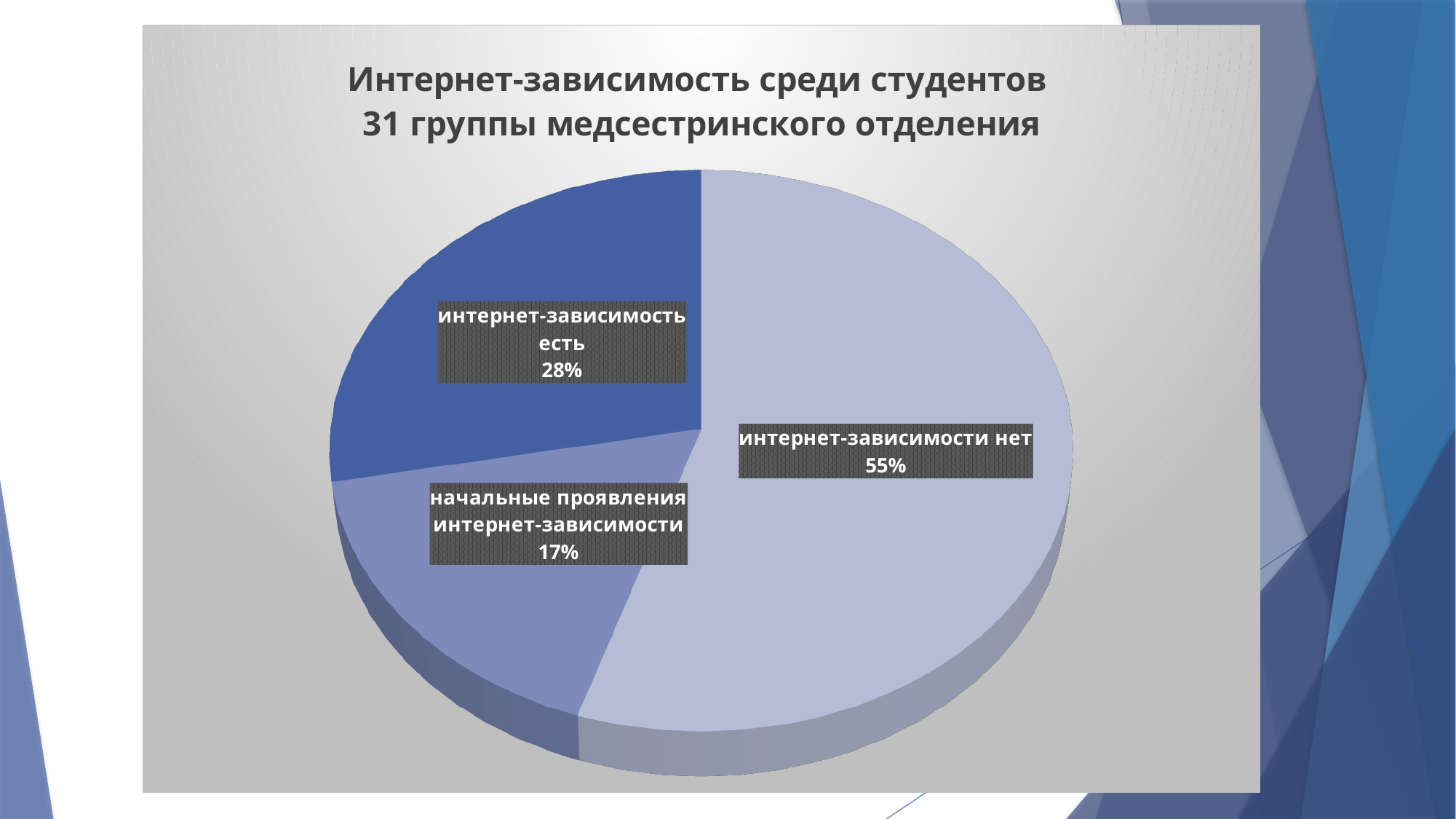
What is the difference in percentage points between 'интернет-зависимость есть' and 'начальные проявления интернет-зависимости'? 11 Is the share for 'интернет-зависимости нет' greater or less than 50%? greater What type of chart is shown on the slide? pie chart Which category has the smallest share of the pie? начальные проявления интернет-зависимости How many slices does the pie chart have? 3 What is the title of the chart? Интернет-зависимость среди студентов 31 группы медсестринского отделения What share of students have no internet addiction (интернет-зависимости нет)? 55% Which category has the largest share of the pie? интернет-зависимости нет What share of students have internet addiction (интернет-зависимость есть)? 28% What is the difference in percentage points between 'интернет-зависимости нет' and 'интернет-зависимость есть'? 27 What share of students show initial signs of internet addiction (начальные проявления интернет-зависимости)? 17% Which is larger: the share for 'интернет-зависимость есть' or for 'начальные проявления интернет-зависимости'? интернет-зависимость есть